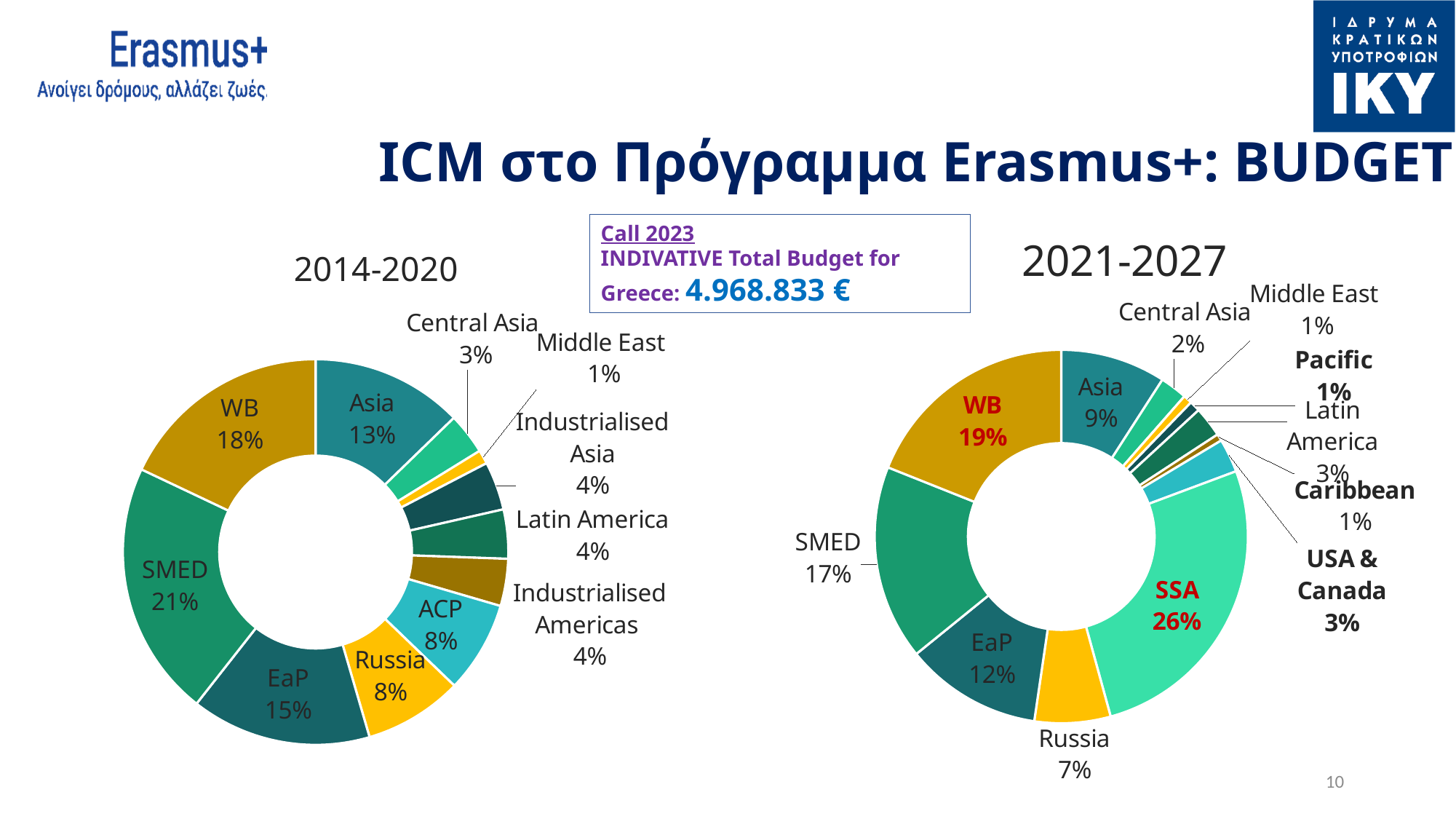
What type of chart is used for the 2021-2027 data? Doughnut (pie) chart In the 2014-2020 chart, what share does SMED have? 21% How many regions are shown in the 2021-2027 chart? 12 In the 2014-2020 chart, which region has the largest share? SMED In the 2014-2020 chart, which is larger, the share for EaP or the share for Asia? EaP What is the indicative total budget for Greece shown in the Call 2023 box? 4.968.833 € In the 2021-2027 chart, what share does SSA have? 26% How many regions are shown in the 2014-2020 chart? 11 In the 2021-2027 chart, which is larger, the share for Russia or the share for Asia? Asia In the 2021-2027 chart, which region has the largest share? SSA In the 2014-2020 chart, which region has the smallest share? Middle East In the 2021-2027 chart, what is the difference between the WB share and the SMED share? 2%